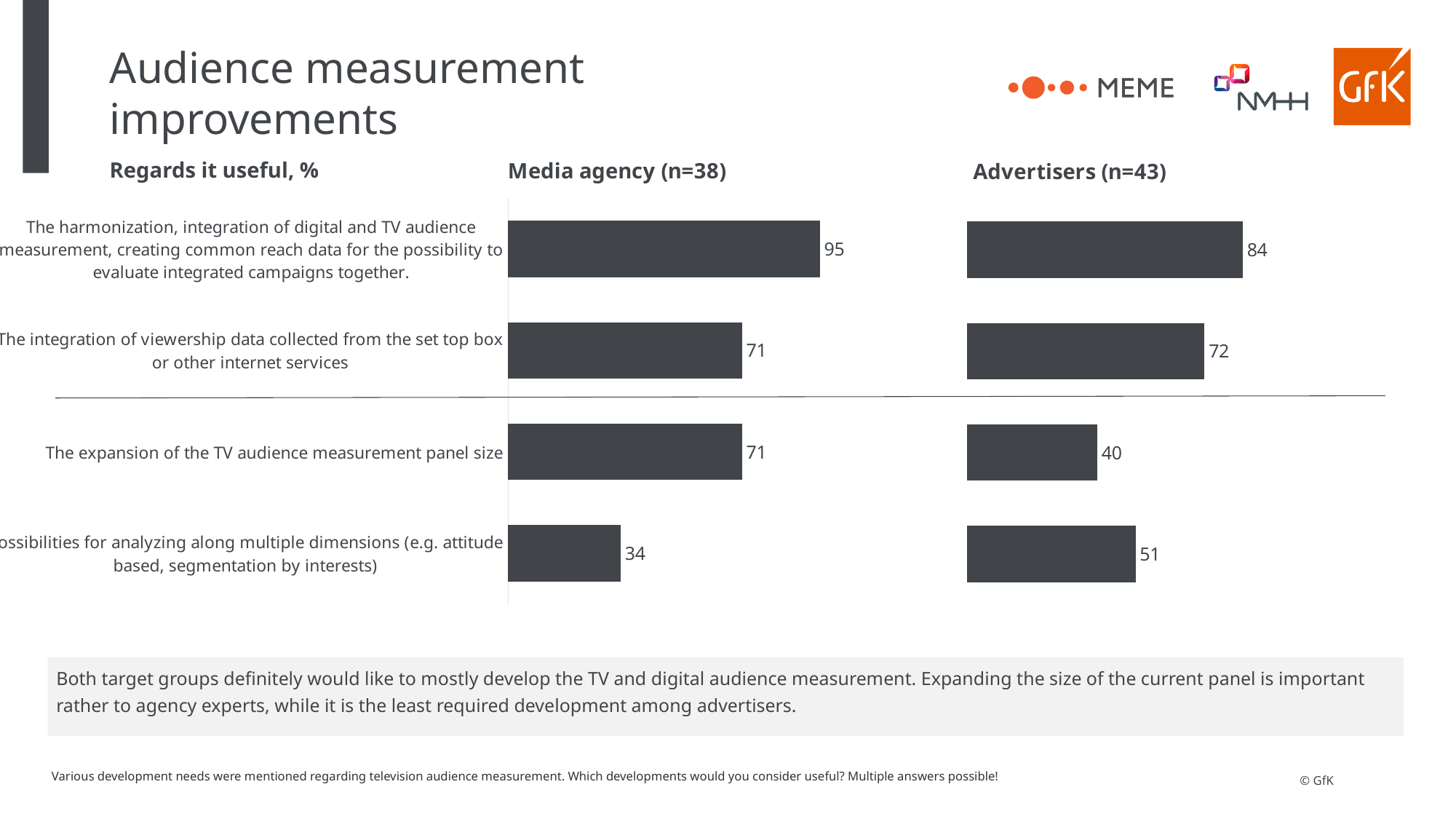
For possibilities for analyzing along multiple dimensions, which group has the larger value: Media agency or Advertisers? Advertisers In the Advertisers (n=43) chart, what is the value for the expansion of the TV audience measurement panel size? 40 What is the difference between the Media agency value (95) and the Advertisers value (84) for the harmonization, integration of digital and TV audience measurement item? 11 In the Advertisers (n=43) chart, which item has the lowest value? The expansion of the TV audience measurement panel size In the Media agency (n=38) chart, which item has the lowest value? Possibilities for analyzing along multiple dimensions (e.g. attitude based, segmentation by interests) In the Advertisers (n=43) chart, which item has the highest value? The harmonization, integration of digital and TV audience measurement, creating common reach data for the possibility to evaluate integrated campaigns together. In the Advertisers (n=43) chart, what is the value for the integration of viewership data collected from the set top box or other internet services? 72 In the Media agency (n=38) chart, what percentage regards the harmonization, integration of digital and TV audience measurement as useful? 95 For the harmonization, integration of digital and TV audience measurement item, which group has the larger value: Media agency or Advertisers? Media agency What is the difference between the Media agency and Advertisers values for the expansion of the TV audience measurement panel size? 31 What type of chart is used to show the Advertisers (n=43) results? Bar chart How many items are plotted in the Media agency (n=38) chart? 4